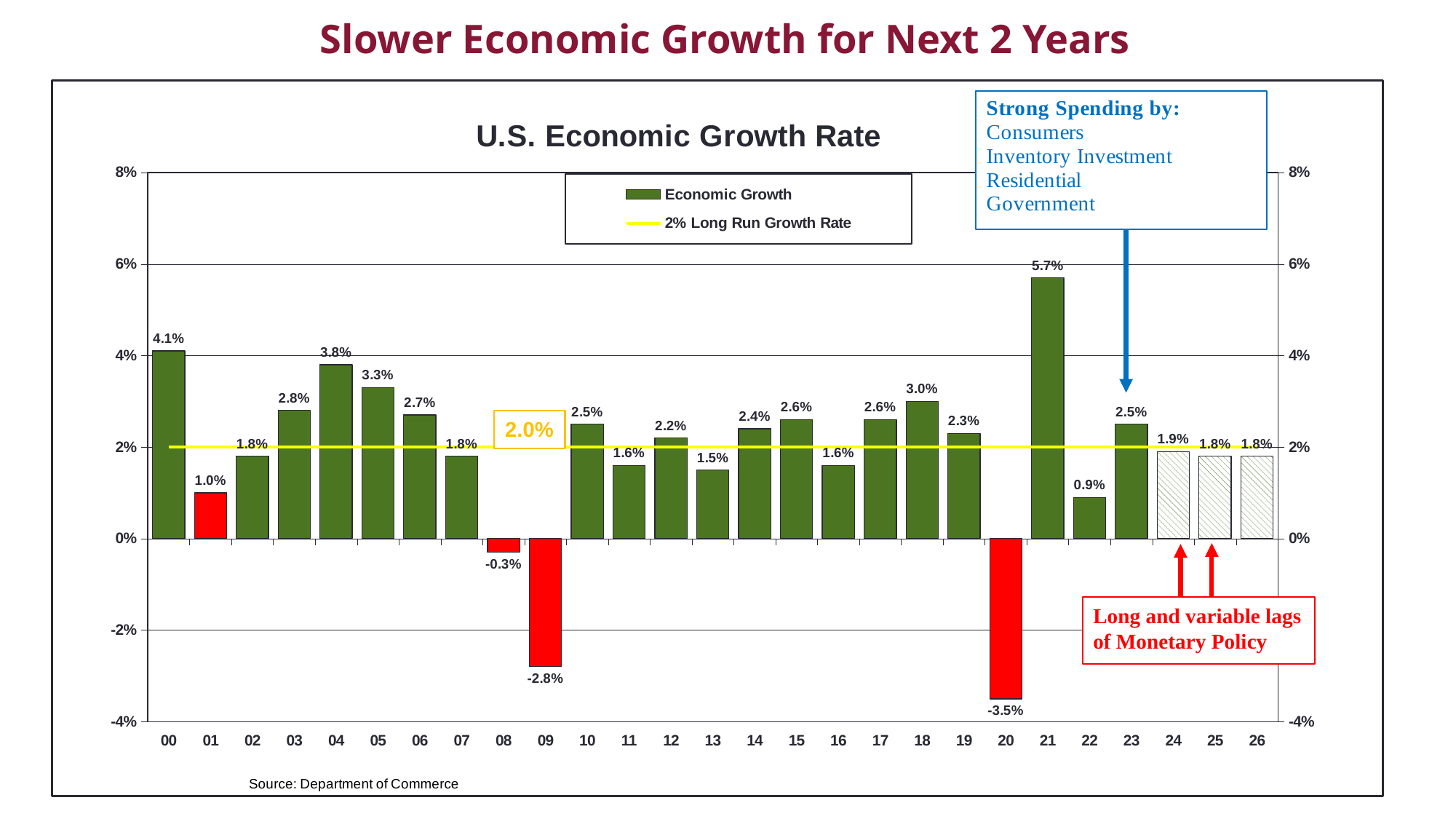
Which year has the lowest economic growth rate? 20 What is the economic growth rate shown for 21? 5.7% What is the economic growth rate shown for 09? -2.8% What is the difference between the growth rate for 00 and the growth rate for 01? 3.1% Which year has the highest economic growth rate? 21 What is the economic growth rate shown for 24? 1.9% What is the title of the chart? U.S. Economic Growth Rate Which is larger, the growth rate for 04 or the growth rate for 05? 04 How many years are shown on the x axis? 27 What kind of chart is used to show the economic growth rate? Bar chart How many series does the legend list? 2 What value does the yellow horizontal line represent? 2.0%